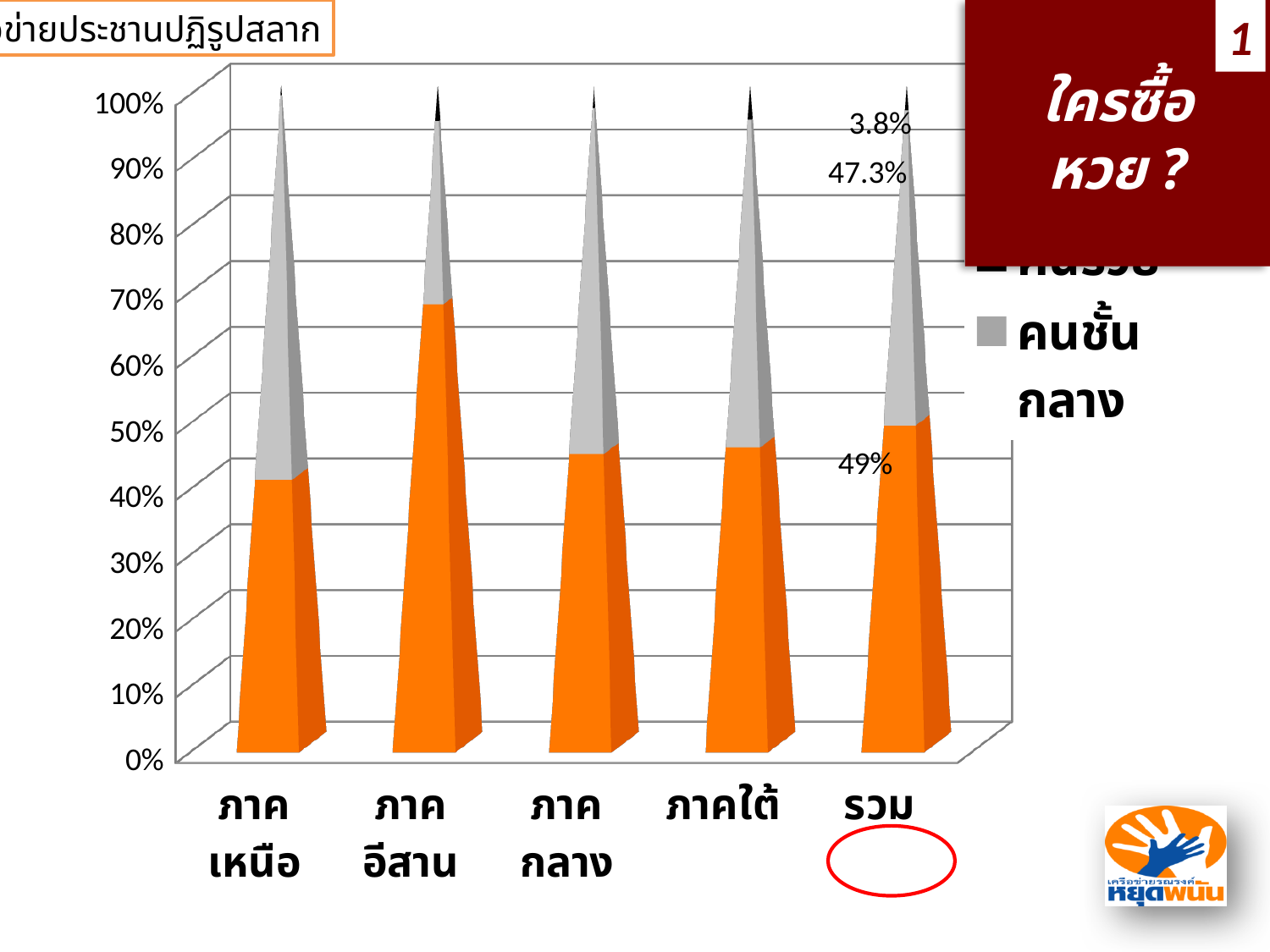
Is the orange segment for ภาคเหนือ greater or less than 50%? less What is the value of the grey (คนชั้นกลาง) segment for รวม? 47.3% Which category label is circled in red below the chart? รวม Is the orange segment for ภาคอีสาน greater or less than 60%? greater How many categories are shown on the x axis? 5 What kind of chart is shown on the slide? A stacked bar chart For รวม, how much larger is the orange segment than the grey (คนชั้นกลาง) segment? 1.7 percentage points For รวม, which is larger: the orange segment or the grey (คนชั้นกลาง) segment? The orange segment What is the value of the orange segment for รวม? 49% What is the value of the small black top segment for รวม? 3.8% Which category has the smallest orange segment? ภาคเหนือ Which category has the largest orange segment? ภาคอีสาน